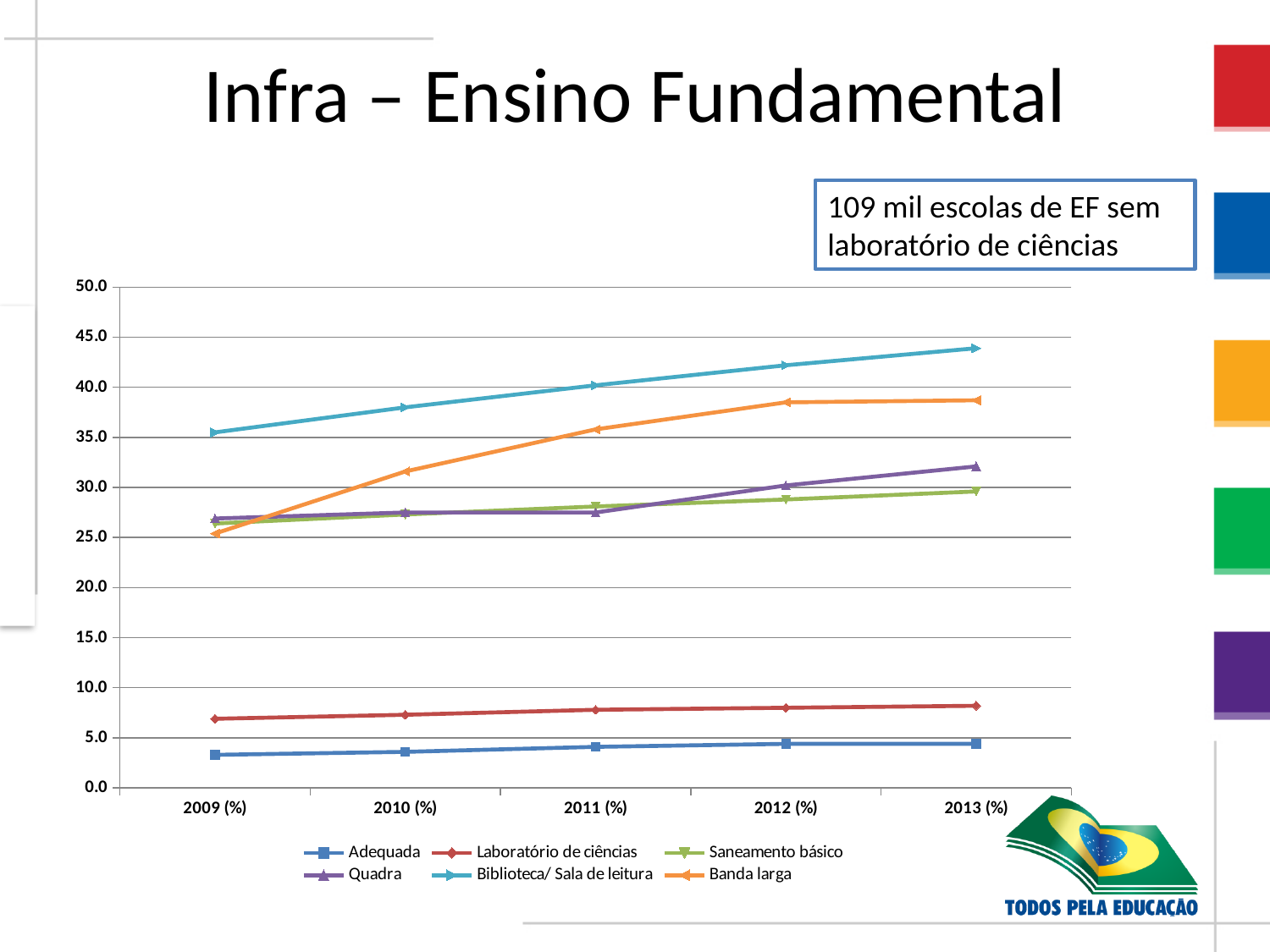
Is the value for Banda larga in 2009 (%) greater or less than 30.0? less Is the value for Laboratório de ciências in 2013 (%) greater or less than 10.0? less How many years are plotted along the x axis of the chart? 5 Does the Biblioteca/ Sala de leitura series rise or fall from 2009 to 2013? rise Does the Banda larga series rise or fall from 2009 to 2013? rise Is the value for Biblioteca/ Sala de leitura in 2013 (%) greater or less than 40.0? greater What is the title of the slide containing the chart? Infra – Ensino Fundamental Which series has the highest value in 2013 (%)? Biblioteca/ Sala de leitura What kind of chart is shown on the slide? line chart In 2013 (%), which is larger: Quadra or Saneamento básico? Quadra Which series has the lowest value in 2013 (%)? Adequada How many series does the chart legend list? 6